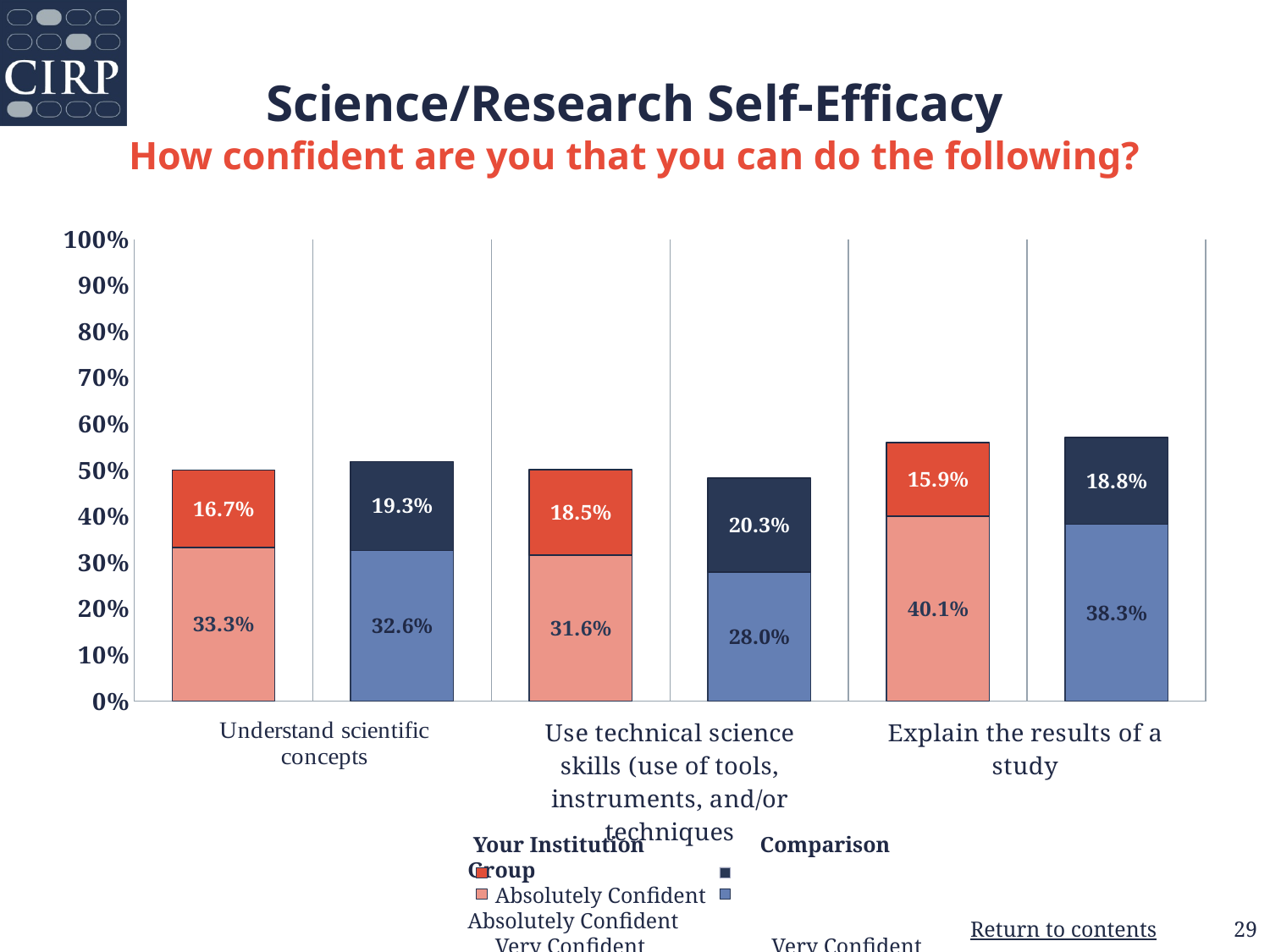
What is the subtitle question shown in orange below the chart title? How confident are you that you can do the following? How many categories are shown along the x axis of the chart? 3 What is the value of the bottom segment of the Comparison Group bar for 'Explain the results of a study'? 38.3% Which category has the highest bottom-segment value for Your Institution? Explain the results of a study What is the value of the bottom segment of the Your Institution bar for 'Understand scientific concepts'? 33.3% Which is larger for 'Explain the results of a study': the top segment of the Your Institution bar or the top segment of the Comparison Group bar? Comparison Group What type of chart is shown on the slide? stacked bar chart What is the value of the top segment of the Comparison Group bar for 'Use technical science skills'? 20.3% What is the difference between the bottom segments of the Your Institution and Comparison Group bars for 'Use technical science skills'? 3.6% What is the total of the Your Institution stacked bar for 'Explain the results of a study'? 56.0% What is the total of the Comparison Group stacked bar for 'Understand scientific concepts'? 51.9% Which category has the lowest bottom-segment value for the Comparison Group? Use technical science skills